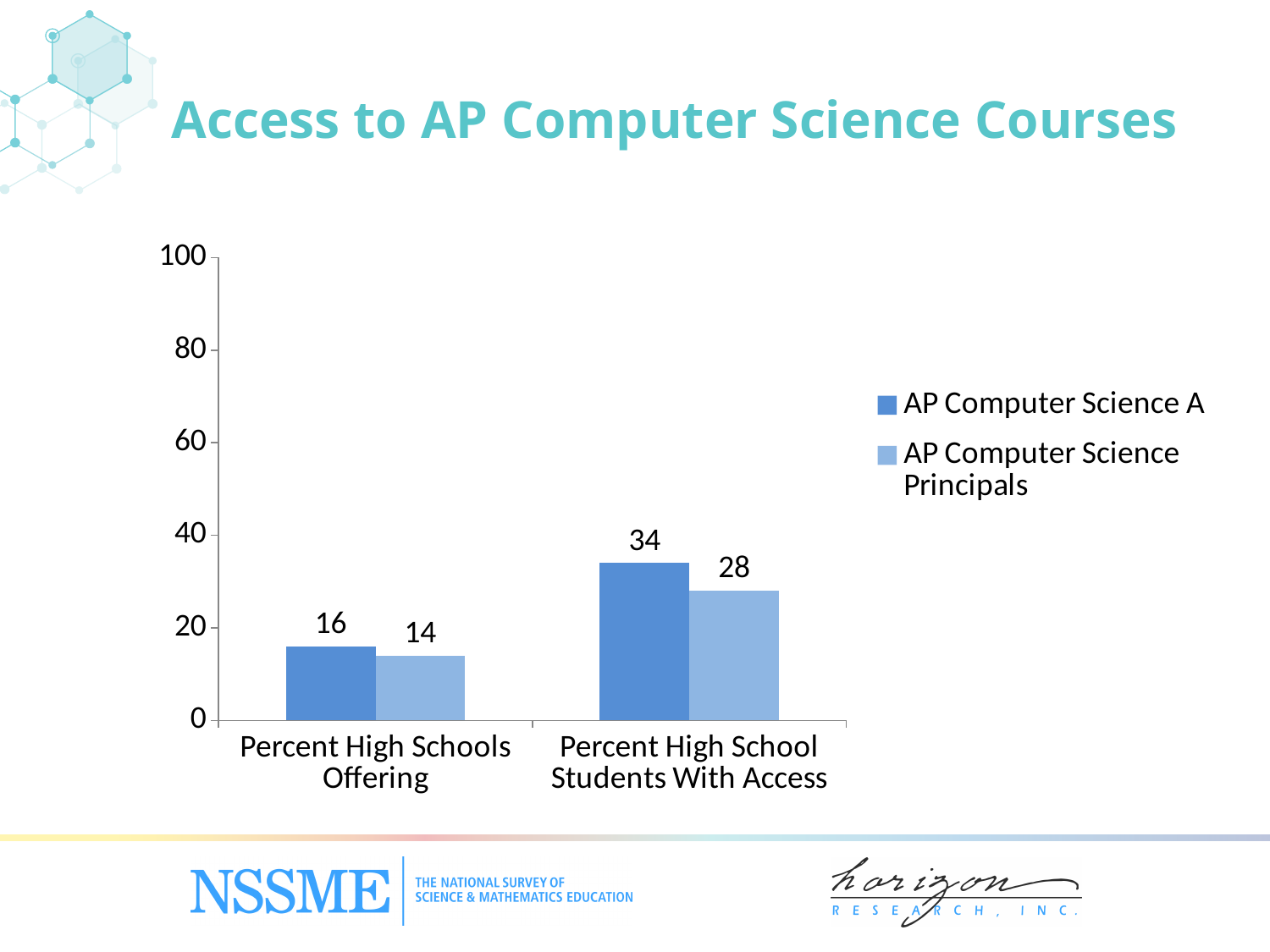
Which is larger for AP Computer Science A: Percent High Schools Offering or Percent High School Students With Access? Percent High School Students With Access Which bar has the highest value on the chart? AP Computer Science A, Percent High School Students With Access What kind of chart is shown on the slide? bar chart What is the value for AP Computer Science A under Percent High School Students With Access? 34 What is the value for AP Computer Science Principals under Percent High School Students With Access? 28 How many categories are shown on the x axis? 2 How many series does the legend list? 2 What is the value for AP Computer Science A under Percent High Schools Offering? 16 Which bar has the lowest value on the chart? AP Computer Science Principals, Percent High Schools Offering Is the value for AP Computer Science A under Percent High School Students With Access greater or less than 40? less What is the difference between AP Computer Science A and AP Computer Science Principals under Percent High School Students With Access? 6 What is the value for AP Computer Science Principals under Percent High Schools Offering? 14